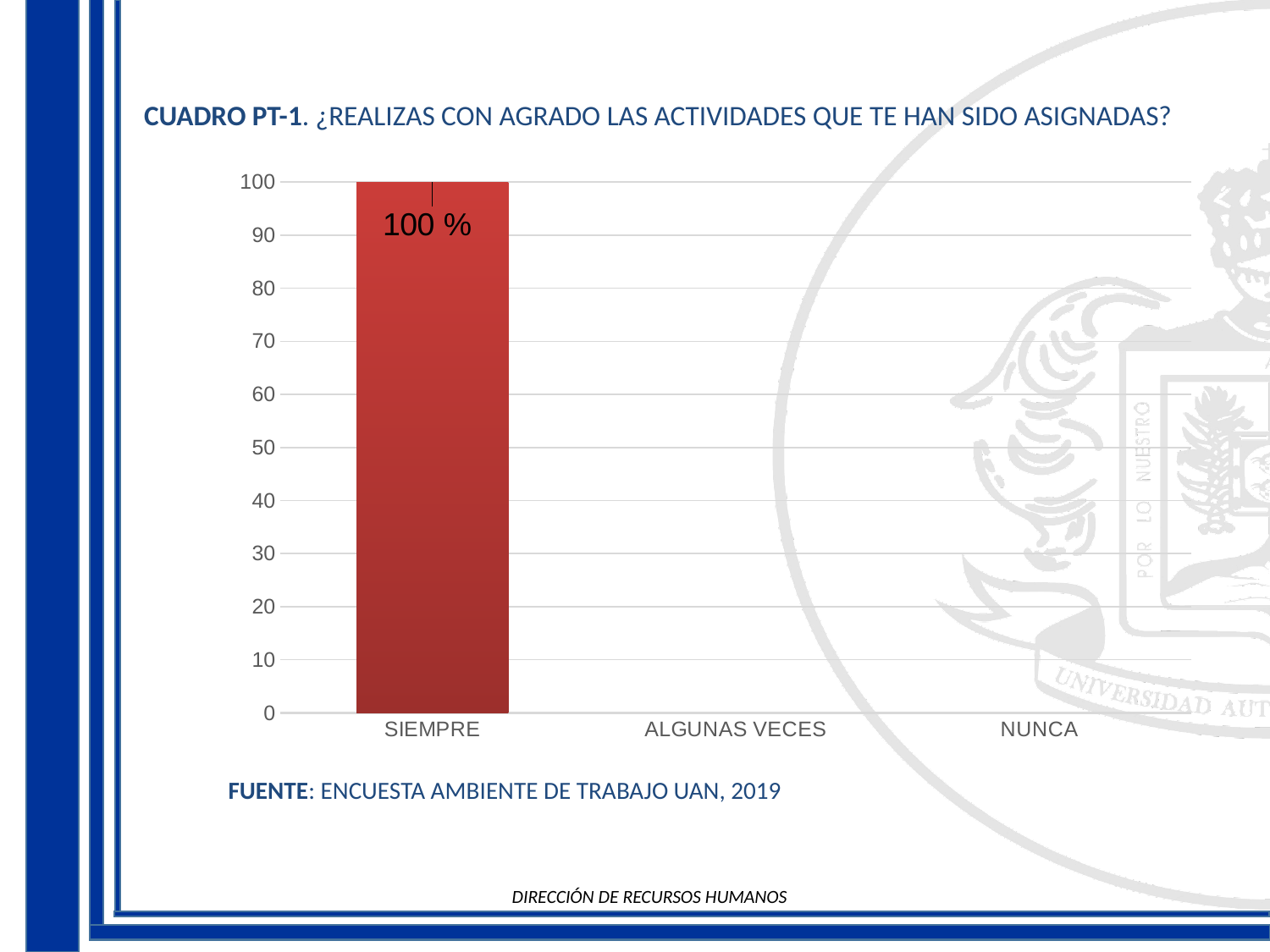
What kind of chart is shown on the slide? Bar chart What value is shown for SIEMPRE? 100 % Is the value for SIEMPRE greater or less than 90? greater Is the value for NUNCA greater or less than 10? less How many categories are shown on the x axis? 3 Which is larger, the value for SIEMPRE or the value for NUNCA? SIEMPRE What is the highest tick value shown on the vertical axis? 100 What is the source cited below the chart? ENCUESTA AMBIENTE DE TRABAJO UAN, 2019 Is the value for ALGUNAS VECES greater or less than 50? less Which category has the highest value? SIEMPRE Which is larger, the value for SIEMPRE or the value for ALGUNAS VECES? SIEMPRE